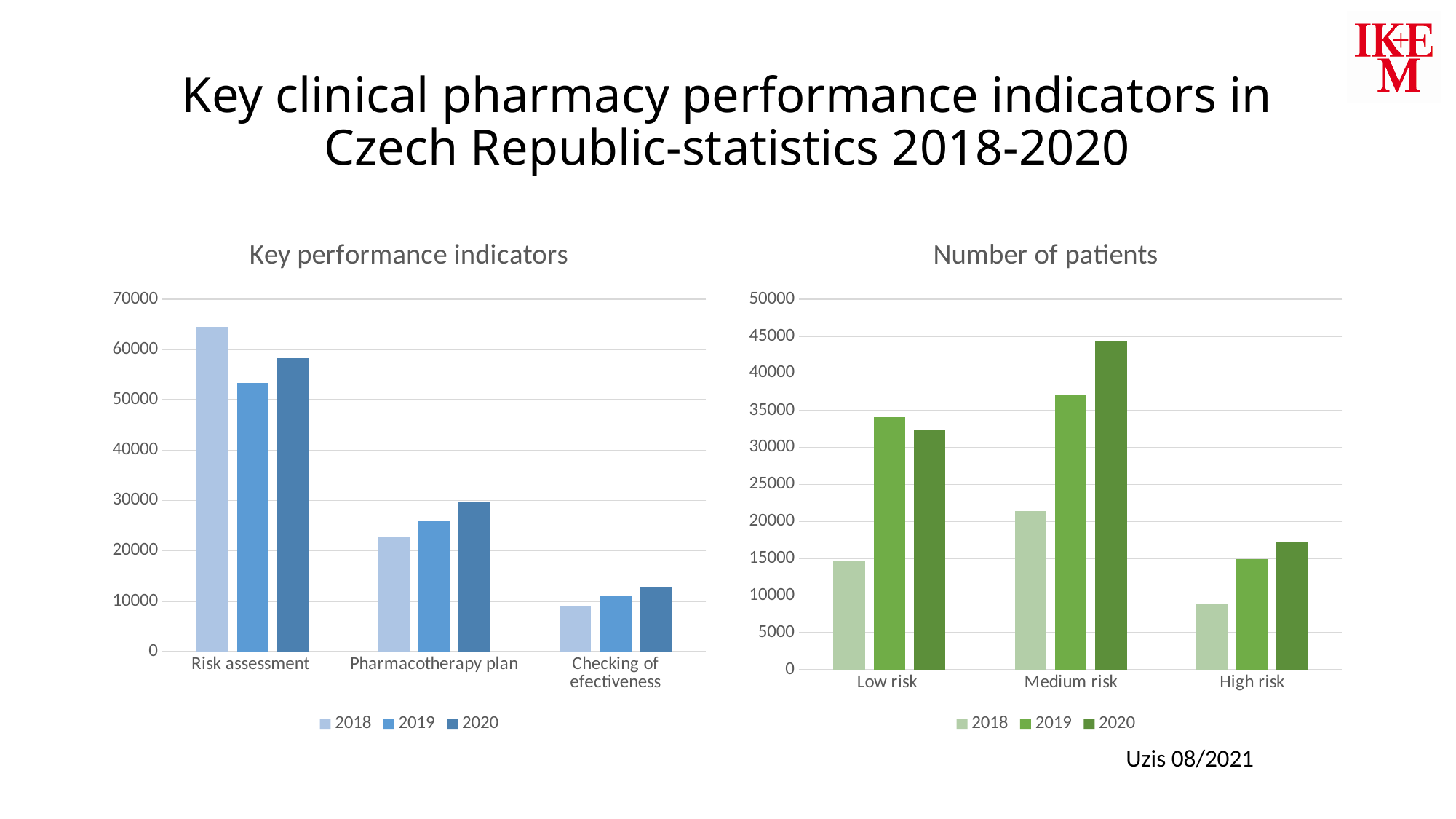
In the "Key performance indicators" chart, which category has the highest 2018 value? Risk assessment What kind of chart is the "Key performance indicators" chart on the left? Bar chart In the "Key performance indicators" chart, do the values for Pharmacotherapy plan rise or fall from 2018 to 2020? rise In the "Key performance indicators" chart, which is larger for Risk assessment: the 2019 value or the 2020 value? 2020 In the "Key performance indicators" chart, is the 2018 value for Risk assessment greater or less than 60000? greater In the "Number of patients" chart, which is larger for Low risk: the 2019 value or the 2020 value? 2019 In the "Number of patients" chart, which category and year has the highest bar overall? Medium risk, 2020 In the "Key performance indicators" chart, how many categories are shown on the x axis? 3 In the "Number of patients" chart, which category has the lowest 2018 value? High risk In the "Number of patients" chart, how many series does the legend list? 3 What are the legend entries of the "Key performance indicators" chart? 2018, 2019, 2020 In the "Number of patients" chart, is the 2020 value for Medium risk greater or less than 40000? greater